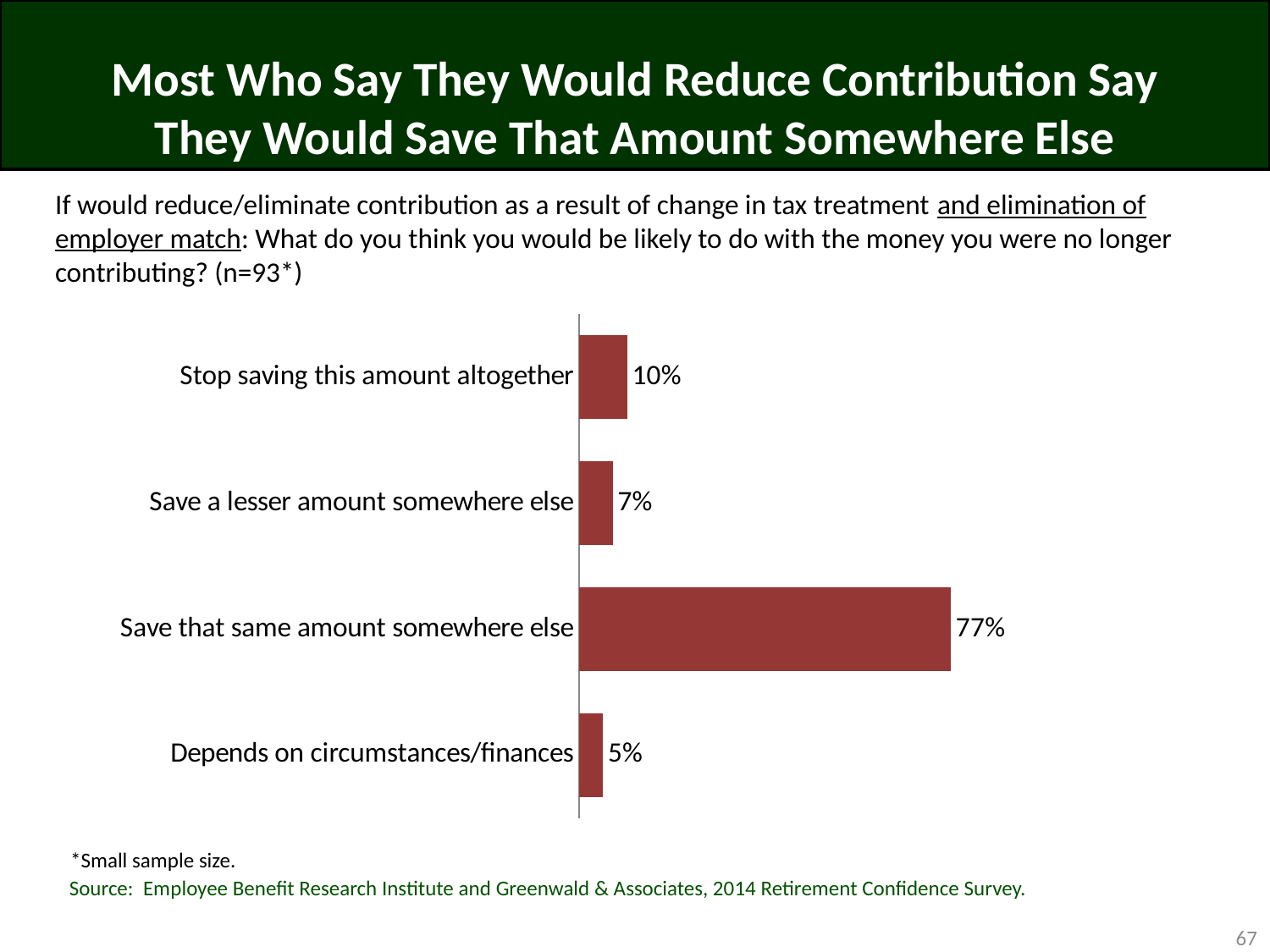
What is the sample size (n) given in the question text above the chart? 93 What percentage of respondents say they would save that same amount somewhere else? 77% How many response categories are shown in the chart? 4 What is the difference in percentage points between 'Stop saving this amount altogether' and 'Save a lesser amount somewhere else'? 3 What percentage of respondents say they would stop saving this amount altogether? 10% What percentage of respondents say they would save a lesser amount somewhere else? 7% Which response has the lowest percentage? Depends on circumstances/finances Which is larger: the percentage for 'Stop saving this amount altogether' or for 'Save a lesser amount somewhere else'? Stop saving this amount altogether What is the difference in percentage points between 'Save that same amount somewhere else' and 'Stop saving this amount altogether'? 67 What percentage of respondents say it depends on circumstances/finances? 5% What kind of chart is shown on the slide? Bar chart Which response has the highest percentage? Save that same amount somewhere else